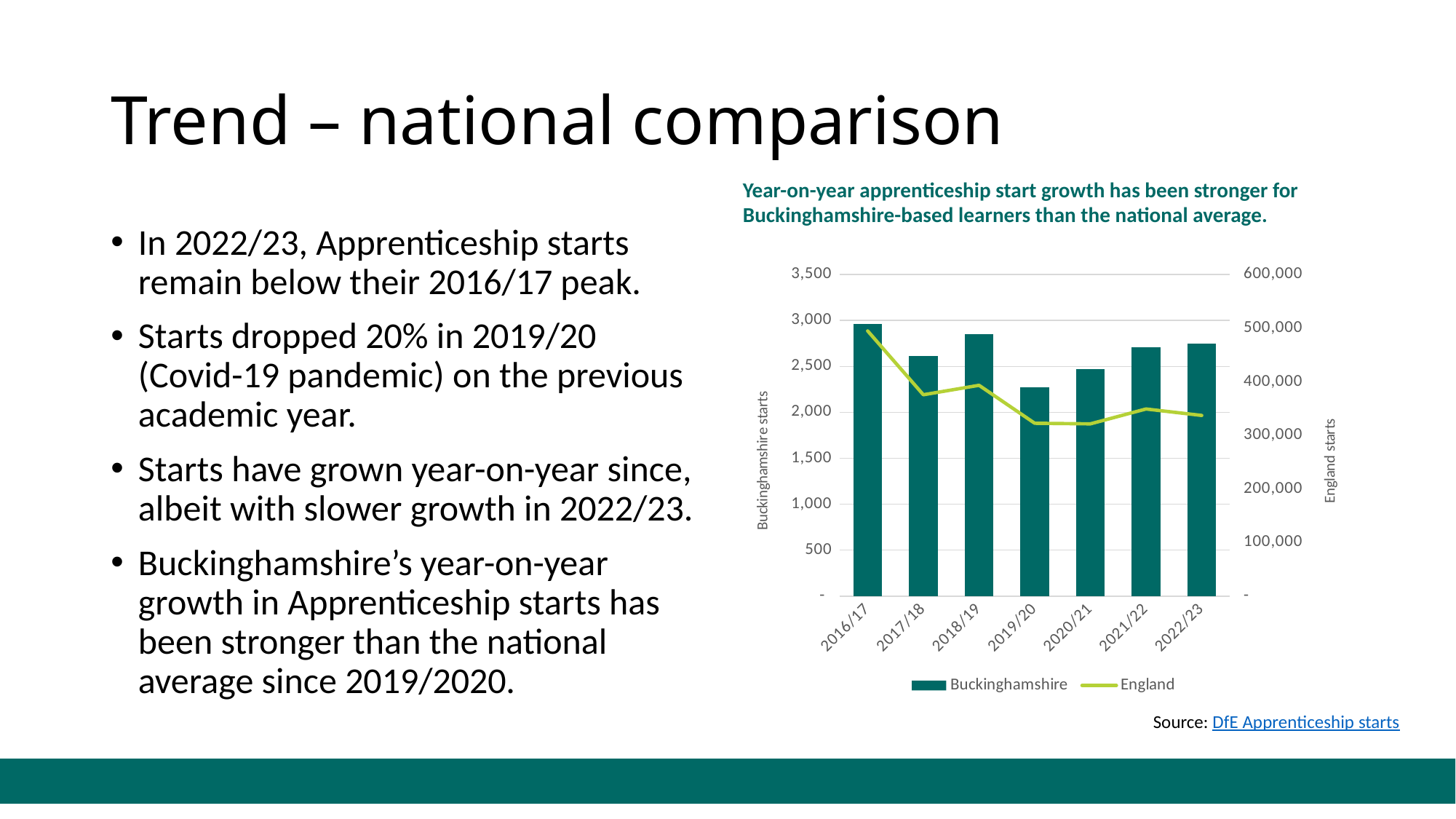
Which academic year has the lowest number of Buckinghamshire starts? 2019/20 Which year has more Buckinghamshire starts, 2017/18 or 2018/19? 2018/19 Which series is plotted as bars in the chart? Buckinghamshire What kind of chart is shown on the slide? A combined bar and line chart Is the value for Buckinghamshire starts in 2019/20 greater or less than 2,500? less Which academic year has the highest number of Buckinghamshire starts? 2016/17 How many series does the chart legend list? 2 Is the value for Buckinghamshire starts in 2016/17 greater or less than 2,500? greater How many academic years are shown on the x axis of the chart? 7 Is the value for England starts in 2020/21 greater or less than 400,000? less Which academic year has the highest number of England starts? 2016/17 Do Buckinghamshire starts rise or fall from 2019/20 to 2022/23? rise